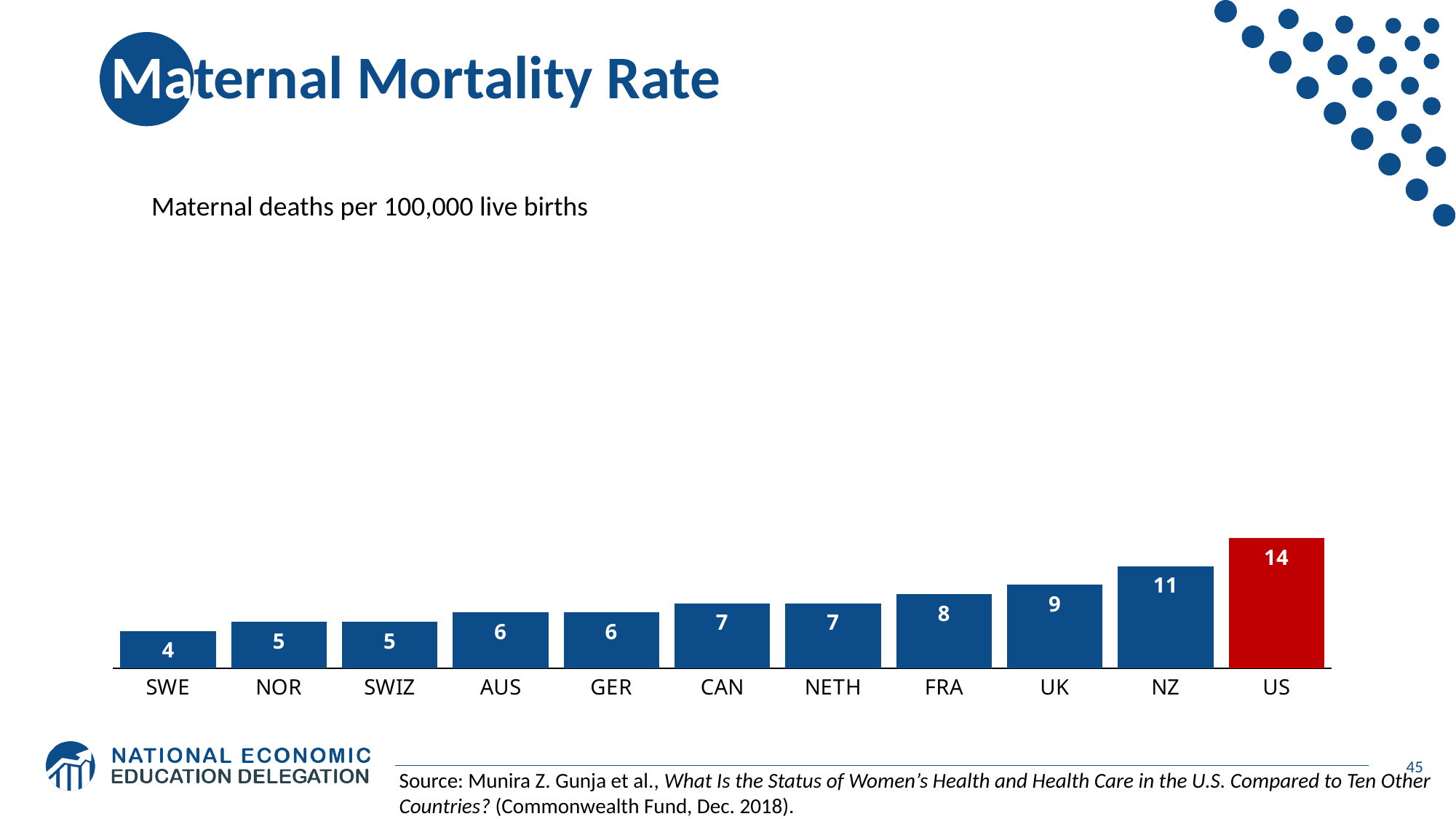
Which country has the lowest maternal mortality rate on the chart? SWE Do the values rise or fall moving from left to right along the x axis? rise Which bar is coloured red rather than blue? US What value is shown for NZ? 11 Which country has the highest maternal mortality rate on the chart? US What value is shown for SWE? 4 What is the difference between the values for the US and the UK? 5 What is the maternal mortality rate shown for the US? 14 What kind of chart is shown on the slide? bar chart How many countries are shown on the chart? 11 What unit is the chart measured in, according to the subtitle? Maternal deaths per 100,000 live births Which has a higher value, FRA or GER? FRA